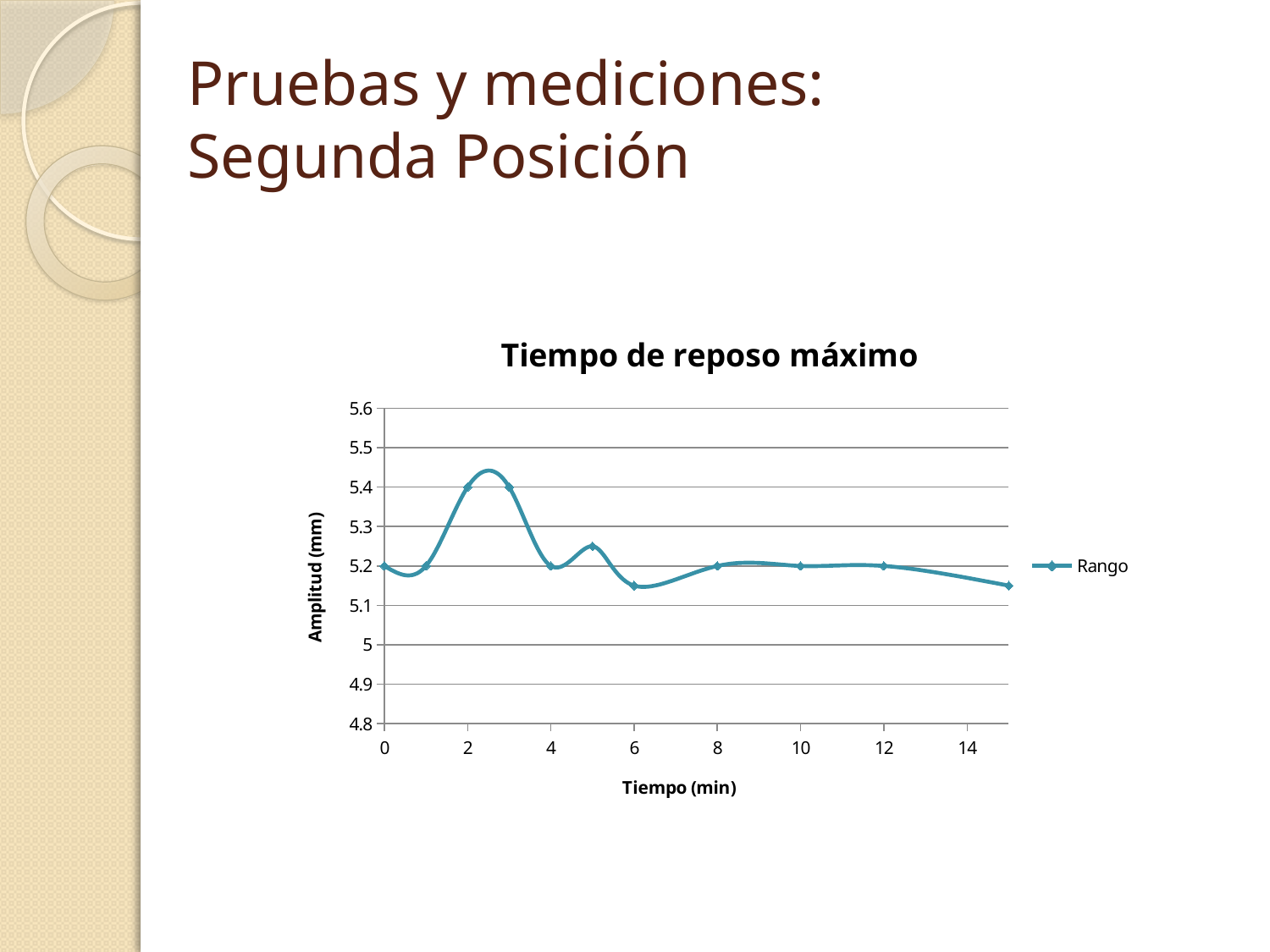
What is the amplitude value at 10 minutes? 5.2 Between 3 and 4 minutes, does the value rise or fall? fall How many data points are plotted on the line? 10 What is the difference between the value at 2 minutes and the value at 0 minutes? 0.2 Which is larger, the value at 2 minutes or the value at 4 minutes? 2 minutes How many series does the legend list? 1 What is the amplitude value at 0 minutes? 5.2 What is the title of the chart? Tiempo de reposo máximo What is the amplitude value at 2 minutes? 5.4 Is the value at 6 minutes greater or less than 5.2? less What is the name of the series shown in the legend? Rango What type of chart is shown on the slide? line chart